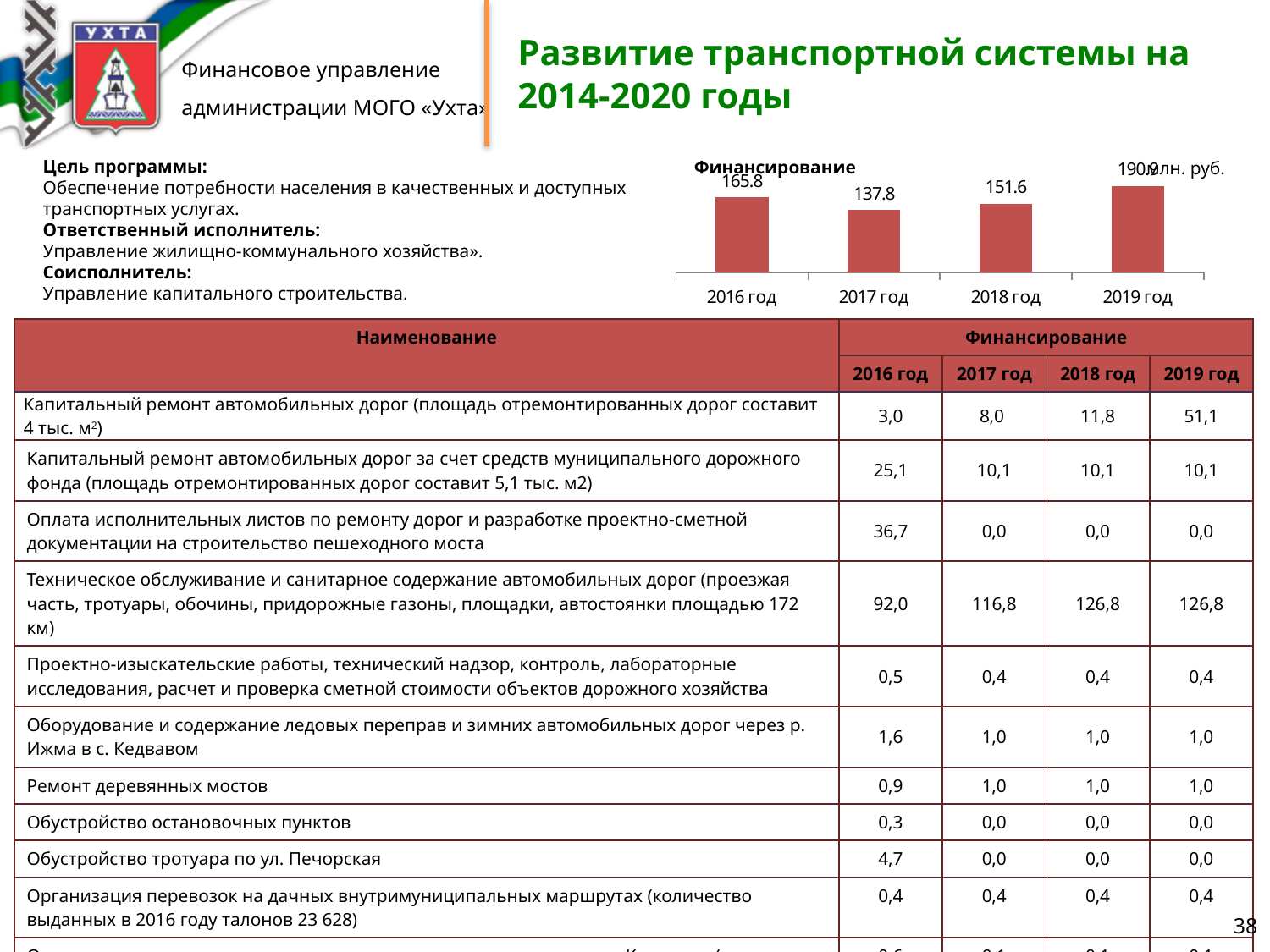
Which is larger in the Финансирование chart, the value for 2016 год or 2018 год? 2016 год What is the value for 2016 год in the Финансирование chart? 165.8 What is the value for 2017 год in the Финансирование chart? 137.8 Does the value in the Финансирование chart rise or fall from 2017 год to 2019 год? rise Which year has the highest bar in the Финансирование chart? 2019 год How many bars are shown in the Финансирование chart? 4 What is the title of the chart on the slide? Финансирование What is the difference between the values for 2018 год and 2017 год in the Финансирование chart? 13.8 What type of chart is the Финансирование chart? bar chart What is the value for 2018 год in the Финансирование chart? 151.6 Which year has the lowest bar in the Финансирование chart? 2017 год What is the difference between the values for 2016 год and 2017 год in the Финансирование chart? 28.0